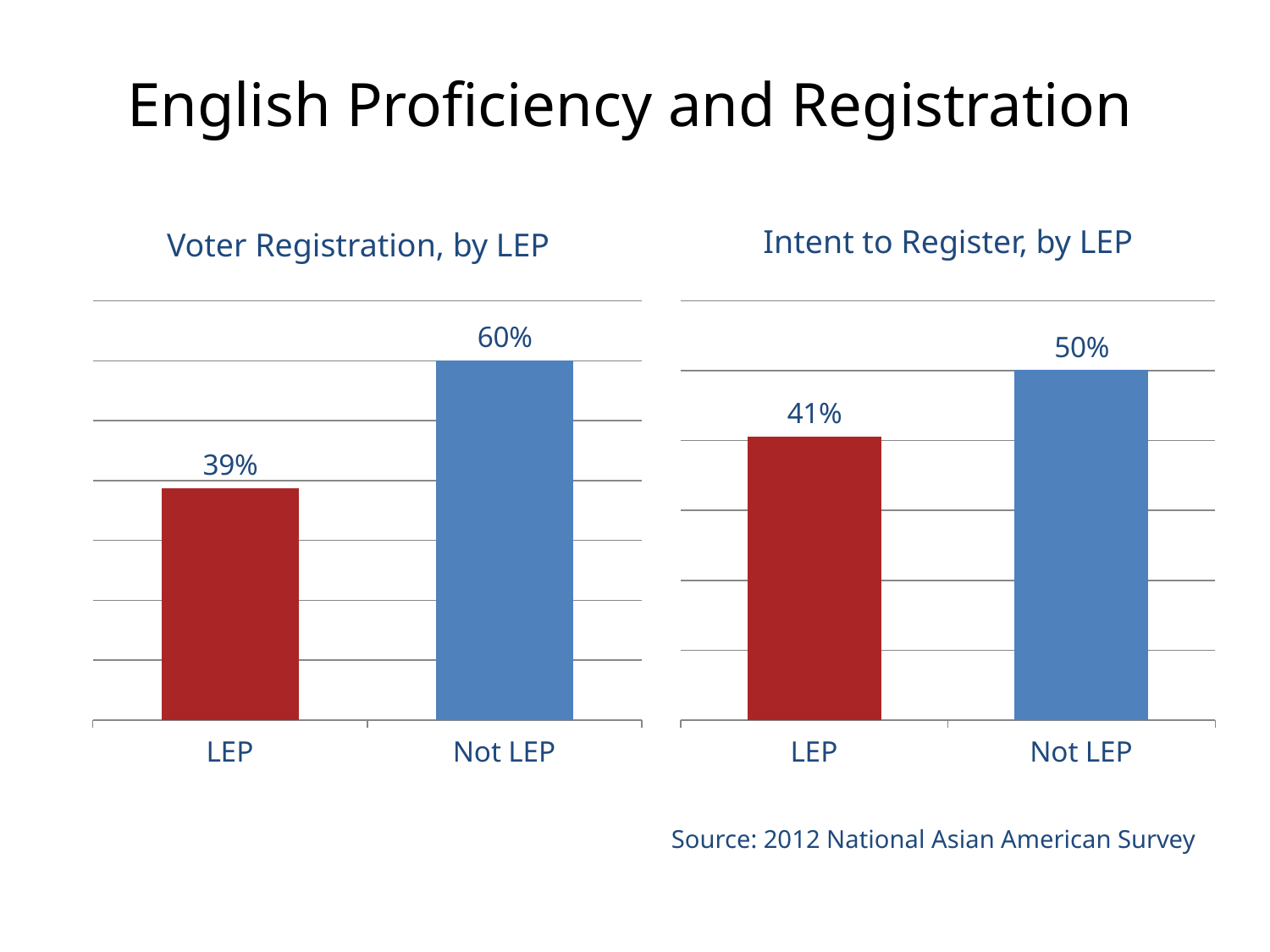
In the 'Intent to Register, by LEP' chart, what is the value for Not LEP? 50% In the 'Intent to Register, by LEP' chart, what is the value for LEP? 41% In the 'Voter Registration, by LEP' chart, which category has the highest value? Not LEP In the 'Intent to Register, by LEP' chart, which category has the lowest value? LEP In the 'Voter Registration, by LEP' chart, what is the value for LEP? 39% What kind of chart is the 'Intent to Register, by LEP' chart? Bar chart What is the title of the chart on the left side of the slide? Voter Registration, by LEP In the 'Intent to Register, by LEP' chart, which is larger, the value for LEP or for Not LEP? Not LEP In the 'Intent to Register, by LEP' chart, what is the difference between the Not LEP and LEP values? 9% In the 'Voter Registration, by LEP' chart, what is the value for Not LEP? 60% How many categories are shown in the 'Voter Registration, by LEP' chart? 2 In the 'Voter Registration, by LEP' chart, what is the difference between the Not LEP and LEP values? 21%